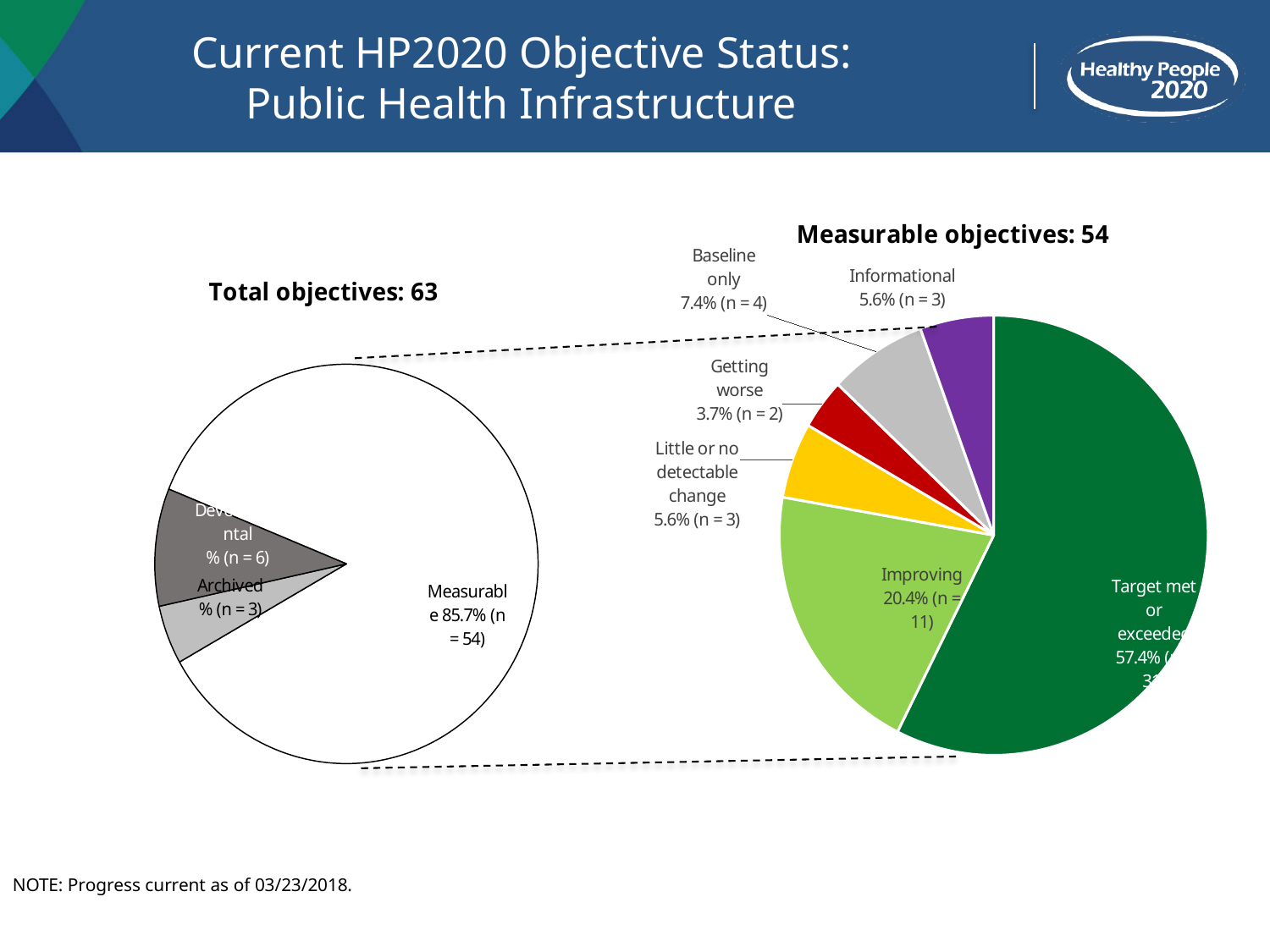
In the 'Measurable objectives: 54' pie chart, what percentage of objectives have Target met or exceeded? 57.4% In the 'Measurable objectives: 54' pie chart, which has a larger share: Baseline only or Informational? Baseline only In the 'Measurable objectives: 54' pie chart, which category has the largest share? Target met or exceeded In the 'Measurable objectives: 54' pie chart, what percentage of objectives are Improving? 20.4% What kind of chart is used on this slide for the measurable objectives? Pie chart In the 'Measurable objectives: 54' pie chart, which category has the smallest share? Getting worse How many slices does the 'Measurable objectives: 54' pie chart have? 6 In the 'Measurable objectives: 54' pie chart, how many more objectives are Improving than Baseline only? 7 What is the title of the pie chart on the right side of the slide? Measurable objectives: 54 In the 'Total objectives: 63' pie chart, what percentage of objectives are Measurable? 85.7% In the 'Measurable objectives: 54' pie chart, how many objectives are Getting worse? n = 2 In the 'Total objectives: 63' pie chart, how many objectives are Archived? n = 3